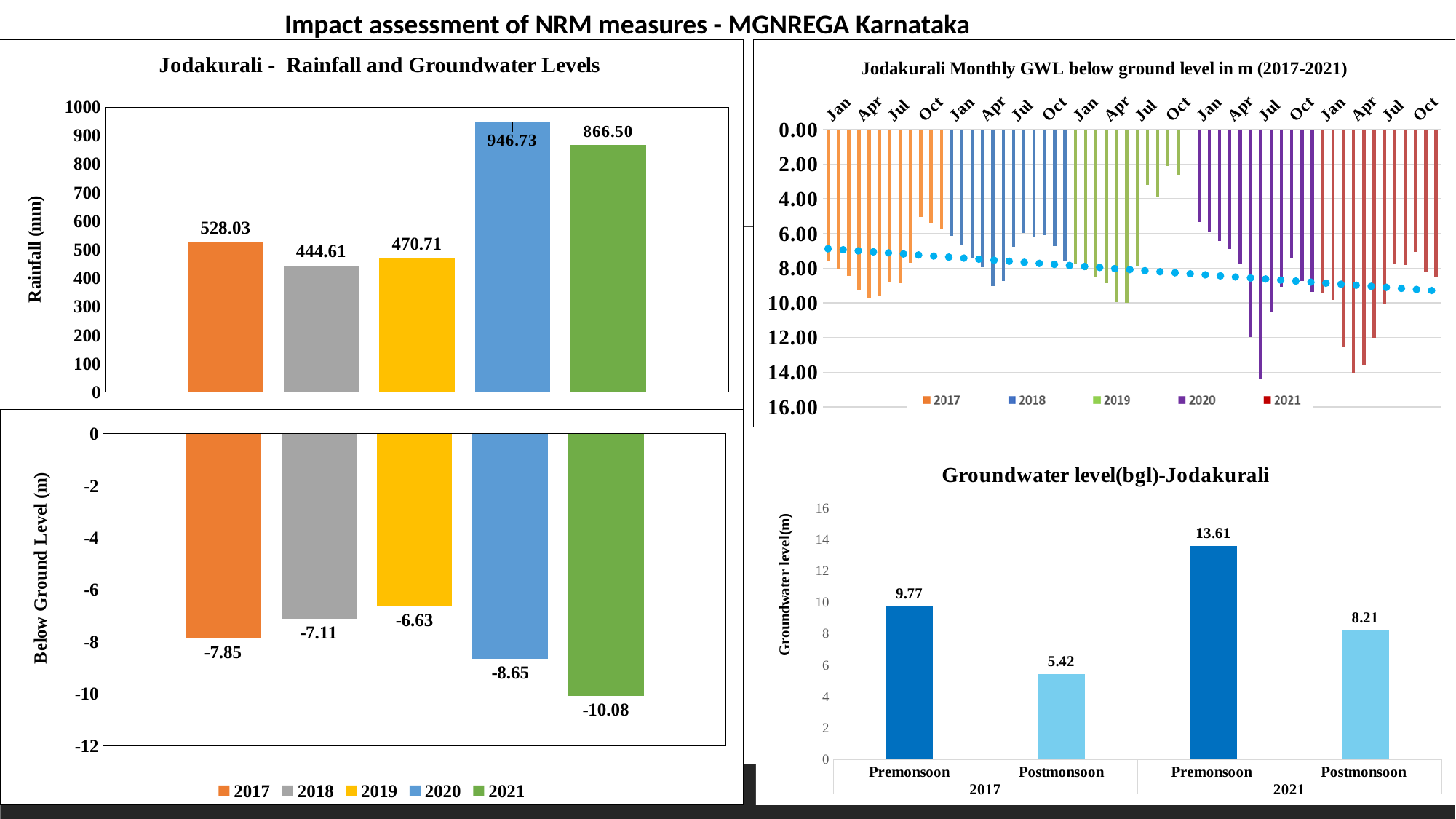
What kind of chart is the 'Groundwater level(bgl)-Jodakurali' chart? bar chart In the bottom-left 'Below Ground Level (m)' chart, what is the value for 2021? -10.08 In the 'Groundwater level(bgl)-Jodakurali' chart, what is the difference between the Premonsoon and Postmonsoon values for 2017? 4.35 In the bottom-left 'Below Ground Level (m)' chart, what is the value for 2019? -6.63 In the bottom-left 'Below Ground Level (m)' chart, how many years are plotted? 5 In the 'Groundwater level(bgl)-Jodakurali' chart, which is larger: the Postmonsoon value for 2017 or the Postmonsoon value for 2021? Postmonsoon 2021 How many series does the legend of the 'Jodakurali Monthly GWL below ground level in m (2017-2021)' chart list? 5 In the 'Jodakurali - Rainfall and Groundwater Levels' chart, what is the rainfall value for 2020? 946.73 In the 'Groundwater level(bgl)-Jodakurali' chart, what is the Premonsoon value for 2021? 13.61 In the 'Jodakurali - Rainfall and Groundwater Levels' chart, which year has the lowest rainfall? 2018 In the 'Jodakurali - Rainfall and Groundwater Levels' chart, what is the difference in rainfall between 2020 and 2021? 80.23 In the 'Jodakurali - Rainfall and Groundwater Levels' chart, is the rainfall for 2019 greater or less than 500? less